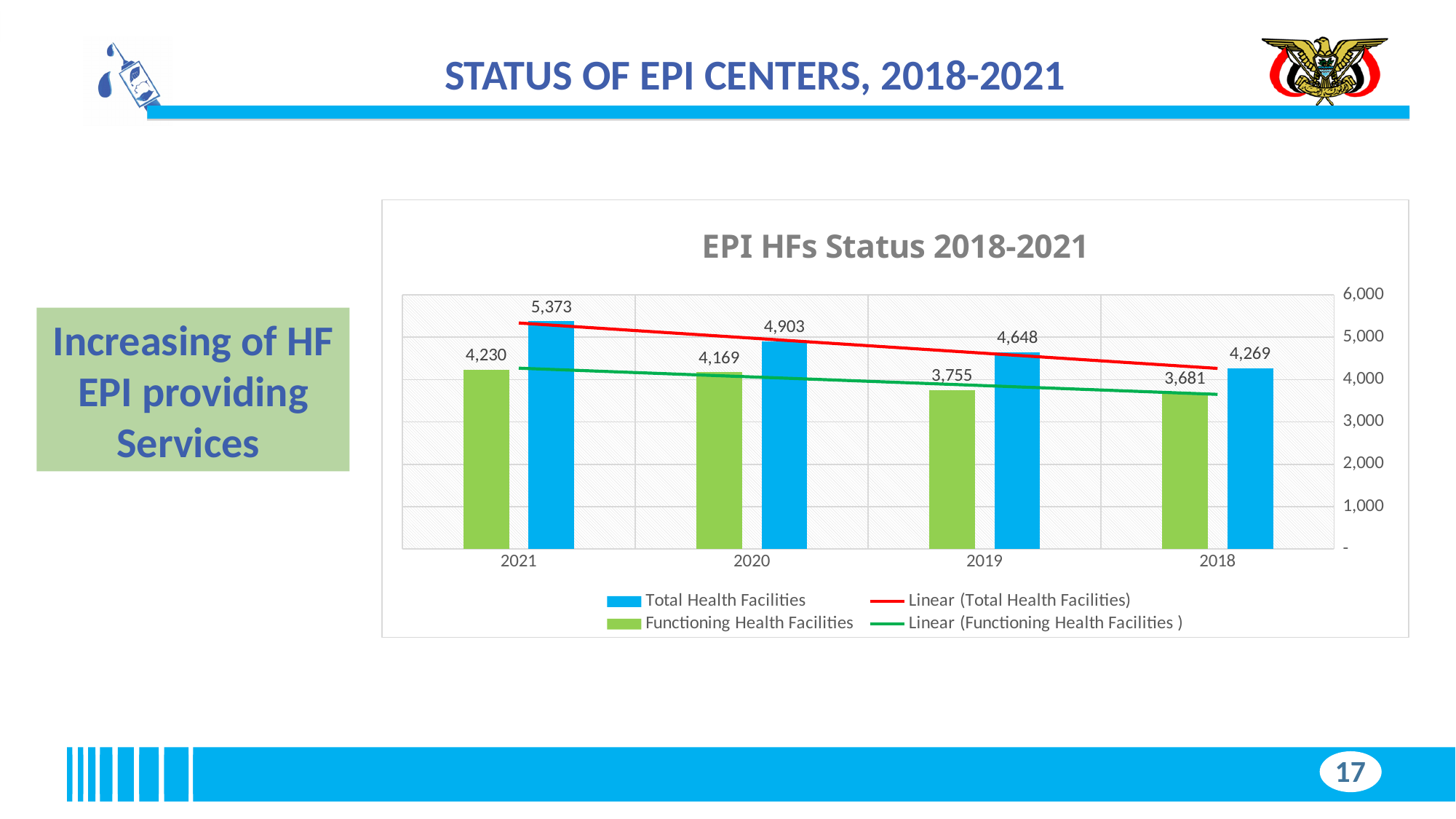
Is the value for Total Health Facilities in 2020 greater or less than 5,000? less What is the value of Functioning Health Facilities for 2019? 3,755 Which year has the highest value for Total Health Facilities? 2021 What is the value of Total Health Facilities for 2018? 4,269 What kind of chart is shown on the slide? bar chart What is the value of Total Health Facilities for 2021? 5,373 Which is larger: Functioning Health Facilities in 2020 or Functioning Health Facilities in 2019? 2020 Do the Total Health Facilities values rise or fall moving left to right along the x axis from 2021 to 2018? fall Which year has the lowest value for Functioning Health Facilities? 2018 What is the difference between Total Health Facilities and Functioning Health Facilities in 2021? 1,143 How many years are shown on the x axis? 4 What is the difference between Total Health Facilities in 2021 and in 2018? 1,104